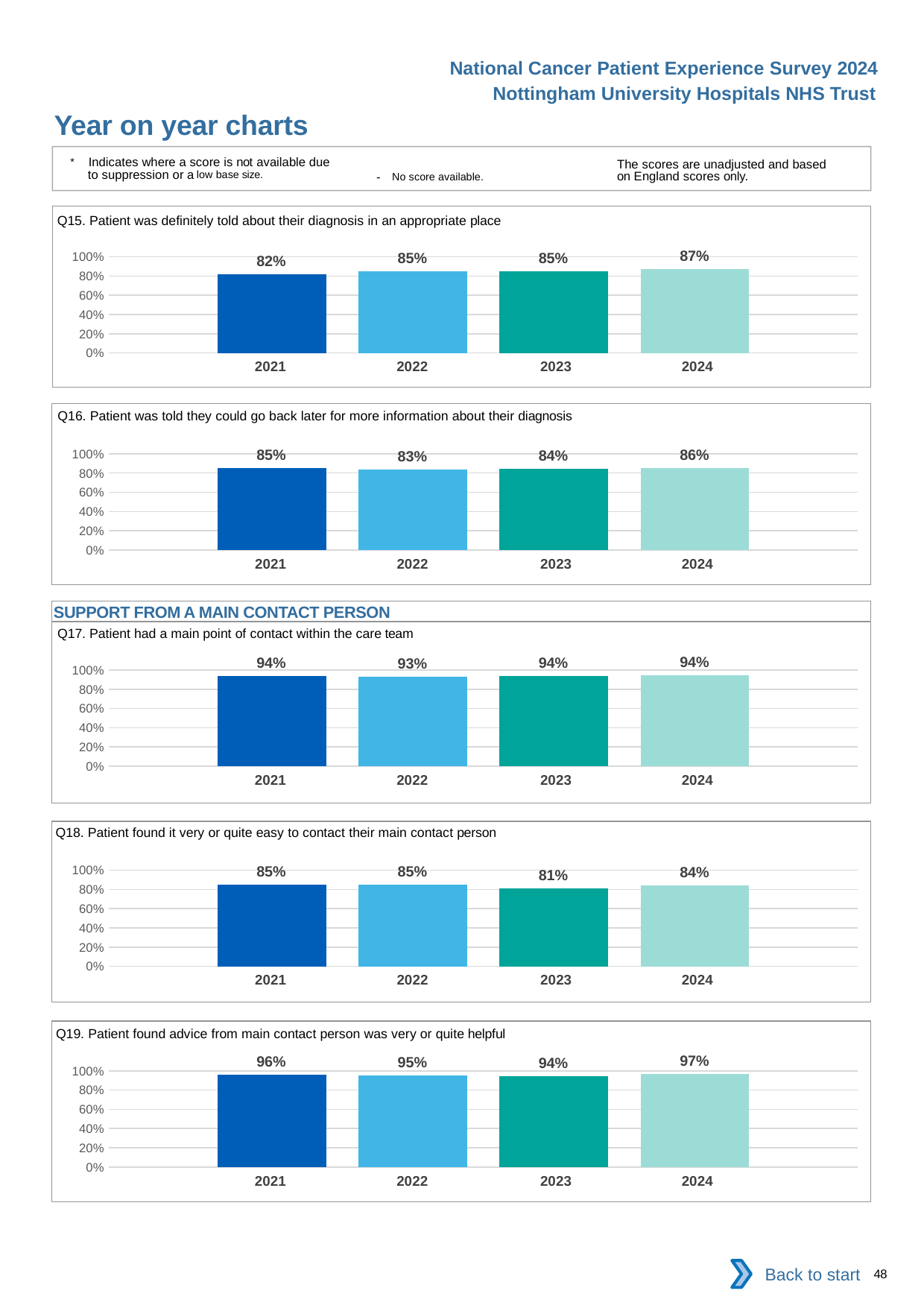
In the Q18 chart, what is the difference between the 2022 value and the 2023 value? 4 percentage points In the Q18 chart, which year has the lowest value? 2023 In the Q16 chart, what is the value for 2022? 83% In the Q17 chart, how many years are plotted? 4 In the Q15 chart, what is the value for 2024? 87% In the Q16 chart, which year has the highest value? 2024 In the Q19 chart, what is the value for 2021? 96% In the Q17 chart, what is the value for 2022? 93% In the Q19 chart, which is larger, the value for 2023 or the value for 2024? 2024 In the Q15 chart, which year has the lowest value? 2021 What kind of chart is the Q19 chart? Bar chart In the Q15 chart, is the value for 2021 greater or less than 80%? greater